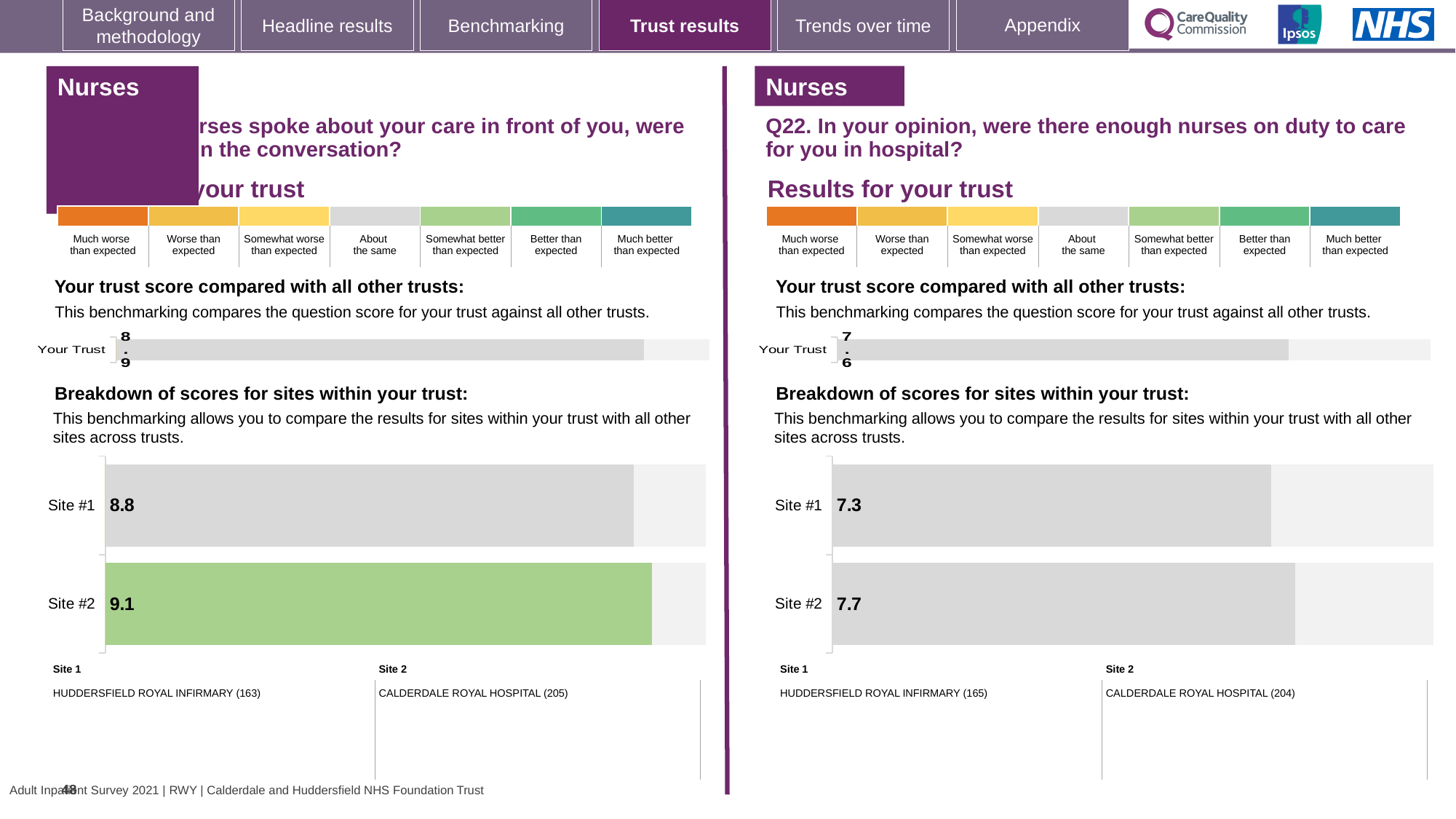
In the left-hand site breakdown chart, which site has the higher score? Site #2 In the left-hand site breakdown chart, what is the score for Site #2? 9.1 In the left-hand site breakdown chart, what is the score for Site #1? 8.8 In the right-hand site breakdown chart (Q22, enough nurses on duty), what is the score for Site #1? 7.3 In the right-hand site breakdown chart (Q22), which site has the lower score? Site #1 How many sites are shown in the right-hand site breakdown chart (Q22)? 2 In the left-hand 'Your trust score compared with all other trusts' chart, what is the score for Your Trust? 8.9 In the right-hand site breakdown chart (Q22, enough nurses on duty), what is the score for Site #2? 7.7 In the right-hand 'Your trust score compared with all other trusts' chart (Q22), what is the score for Your Trust? 7.6 In the left-hand site breakdown chart, what is the difference between the Site #2 and Site #1 scores? 0.3 In the right-hand site breakdown chart (Q22), what is the difference between the Site #2 and Site #1 scores? 0.4 What type of chart is used for the site breakdown on the left-hand side of the slide? Bar chart